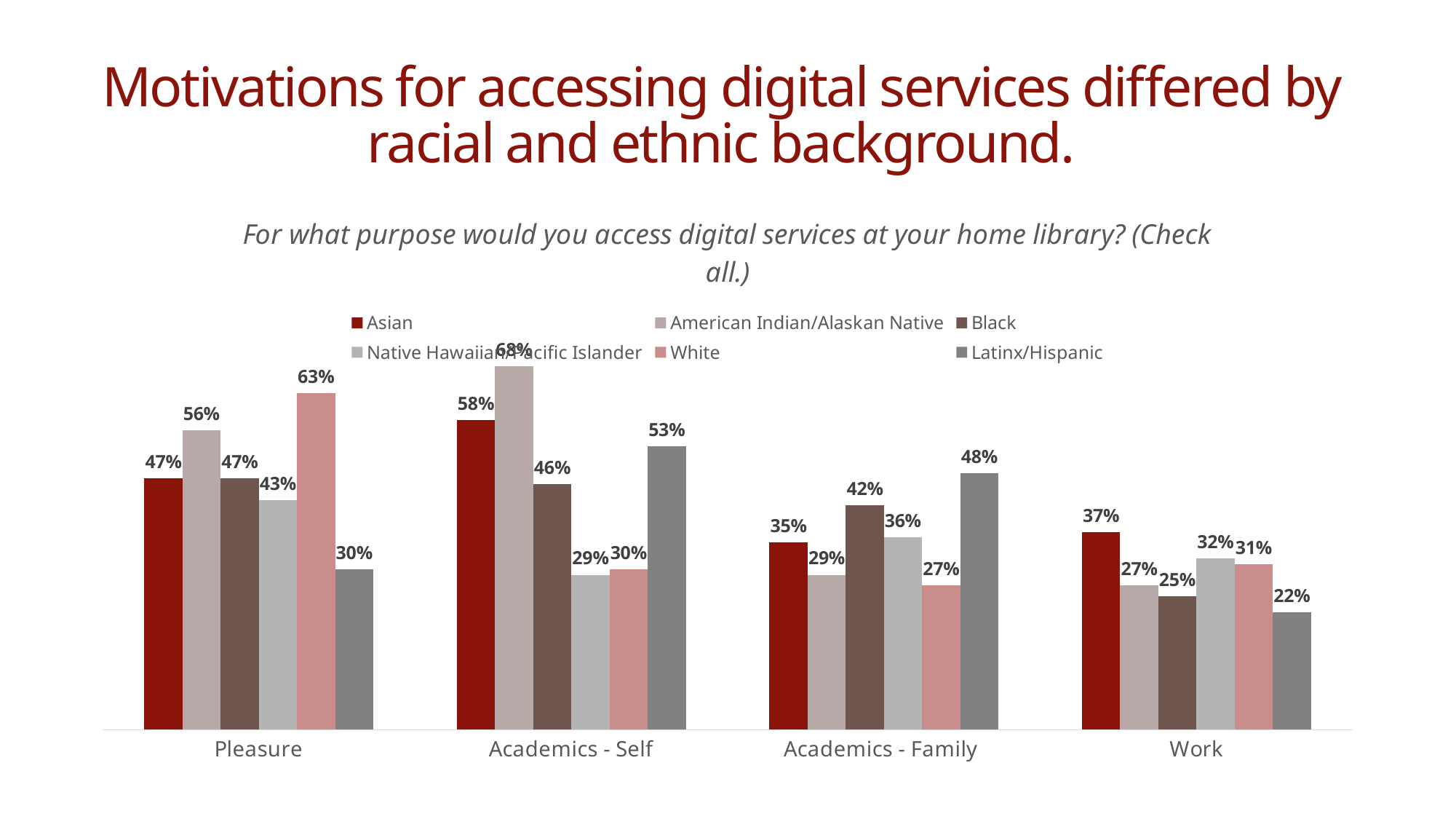
Which group has the lowest value in the Pleasure category? Latinx/Hispanic How many series does the legend list? 6 What kind of chart is shown on the slide? Bar chart Which group has the lowest value in the Work category? Latinx/Hispanic What is the value for Latinx/Hispanic respondents in the Academics - Family category? 48% In the Academics - Family category, which is larger: the Black value or the Native Hawaiian/Pacific Islander value? Black How many purpose categories are shown on the x axis? 4 What is the difference between the White and Latinx/Hispanic values in the Pleasure category? 33% What is the value for Asian respondents in the Work category? 37% What survey question is shown as the chart's subtitle? For what purpose would you access digital services at your home library? (Check all.) What percentage of White respondents would access digital services for Pleasure? 63% Which group has the highest value in the Academics - Self category? American Indian/Alaskan Native